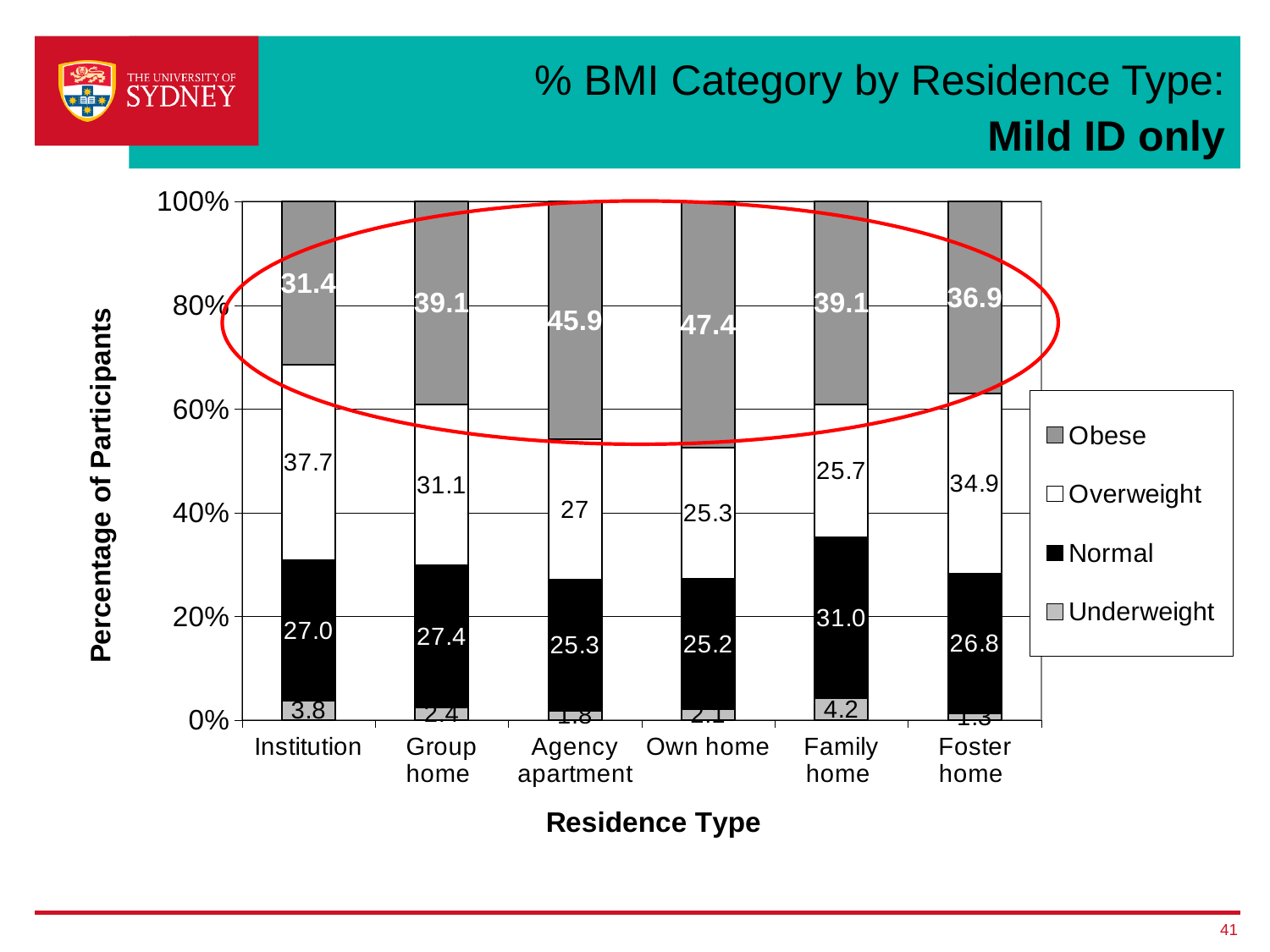
Which has the larger Overweight percentage, Institution or Foster home? Institution What is the difference between the Obese percentage for Own home and for Institution? 16.0 What is the Normal percentage for Family home? 31.0 What is the Underweight percentage for Family home? 4.2 What kind of chart is shown on the slide? stacked bar chart What is the Obese percentage for Own home? 47.4 How many residence types are shown on the x axis? 6 Which residence type has the highest Obese percentage? Own home What is the Overweight percentage for Institution? 37.7 How many series does the legend list? 4 Which residence type has the lowest Obese percentage? Institution What is the title of the x axis? Residence Type